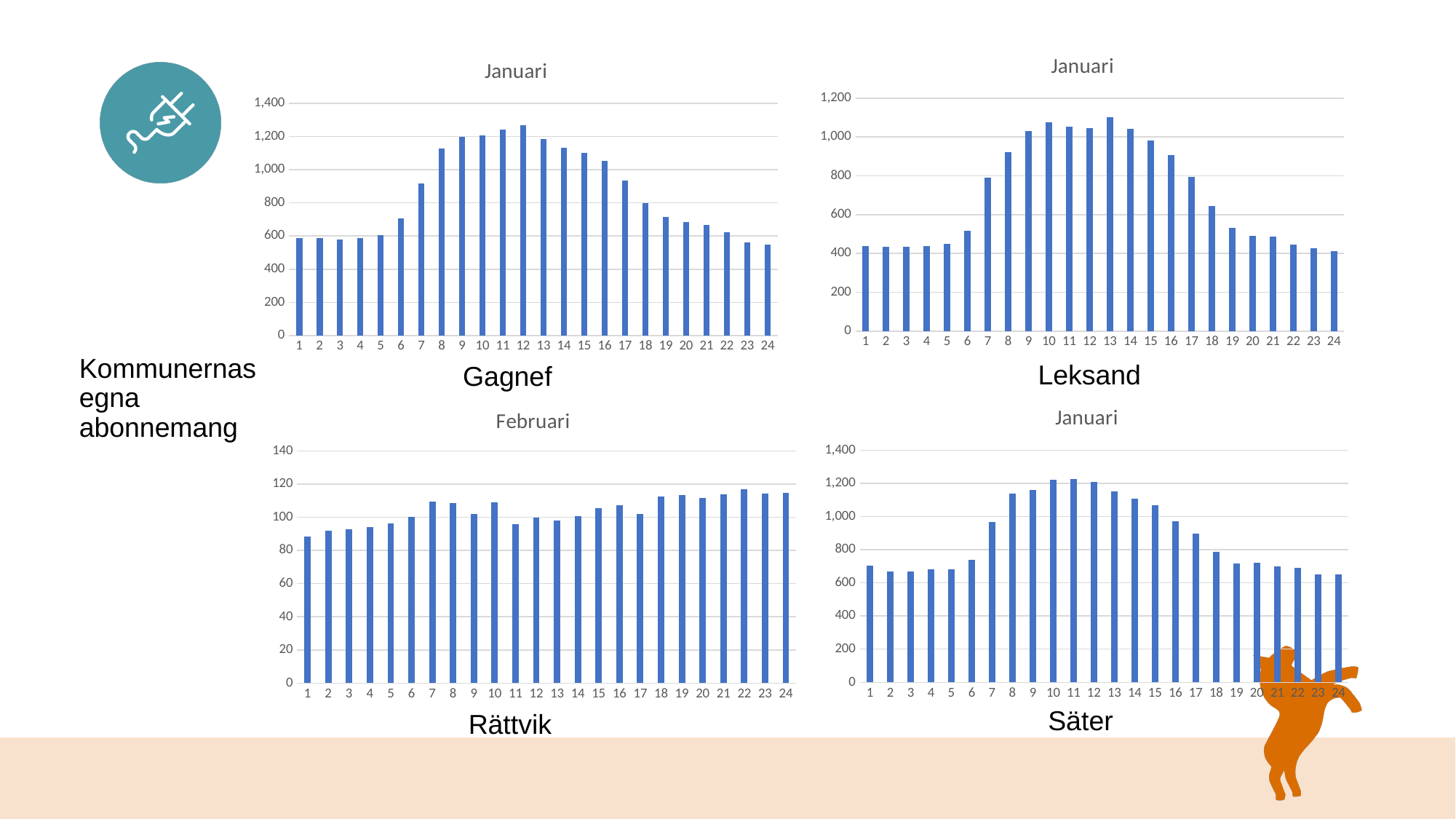
In the Leksand chart, which category has the highest value? 13 In the Gagnef chart, which category has the highest value? 12 In the Rättvik chart, do the values generally rise or fall from category 1 to category 24? rise How many categories are shown on the x axis of the Leksand chart? 24 In the Rättvik chart, is the value for category 1 greater or less than 100? less In the Leksand chart, is the value for category 13 greater or less than 1,000? greater What is the title shown above the Rättvik chart? Februari In the Gagnef chart, is the value for category 1 greater or less than 800? less In the Rättvik chart, which category has the lowest value? 1 What kind of chart is the Gagnef chart? bar chart